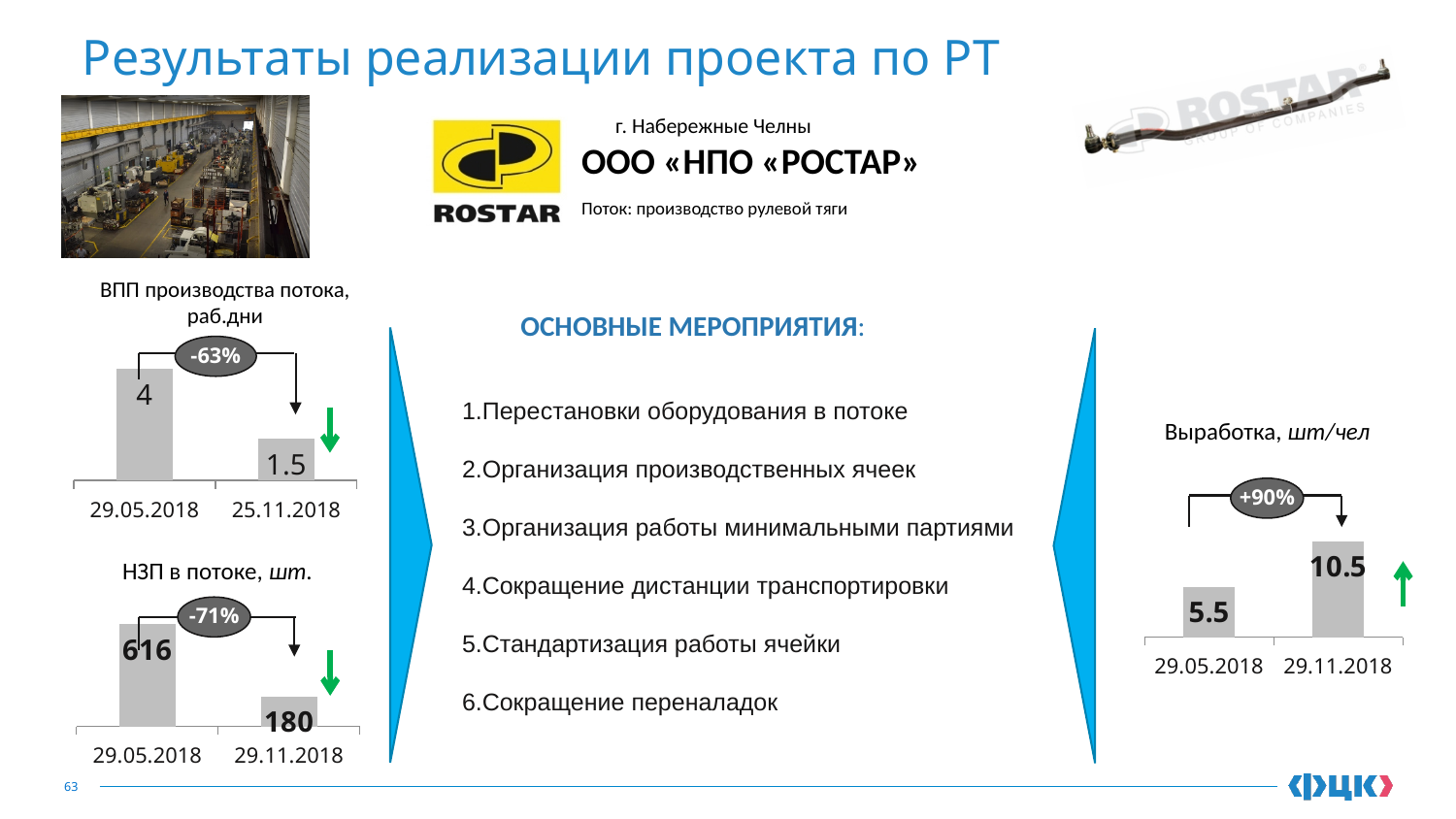
In the chart titled 'ВПП производства потока, раб.дни', which date has the larger value, 29.05.2018 or 25.11.2018? 29.05.2018 In the chart titled 'НЗП в потоке, шт.', what is the difference between the values for 29.05.2018 and 29.11.2018? 436 In the chart titled 'Выработка, шт/чел', which date has the lower value? 29.05.2018 In the chart titled 'ВПП производства потока, раб.дни', what is the value for 25.11.2018? 1.5 In the chart titled 'НЗП в потоке, шт.', what is the value for 29.05.2018? 616 In the chart titled 'Выработка, шт/чел', what is the difference between the values for 29.11.2018 and 29.05.2018? 5 What kind of chart is the chart titled 'НЗП в потоке, шт.'? bar chart In the chart titled 'ВПП производства потока, раб.дни', what is the value for 29.05.2018? 4 In the chart titled 'НЗП в потоке, шт.', what is the value for 29.11.2018? 180 In the chart titled 'Выработка, шт/чел', do the values rise or fall from 29.05.2018 to 29.11.2018? rise In the chart titled 'Выработка, шт/чел', what is the value for 29.11.2018? 10.5 What percentage change is shown in the callout on the chart titled 'НЗП в потоке, шт.'? -71%